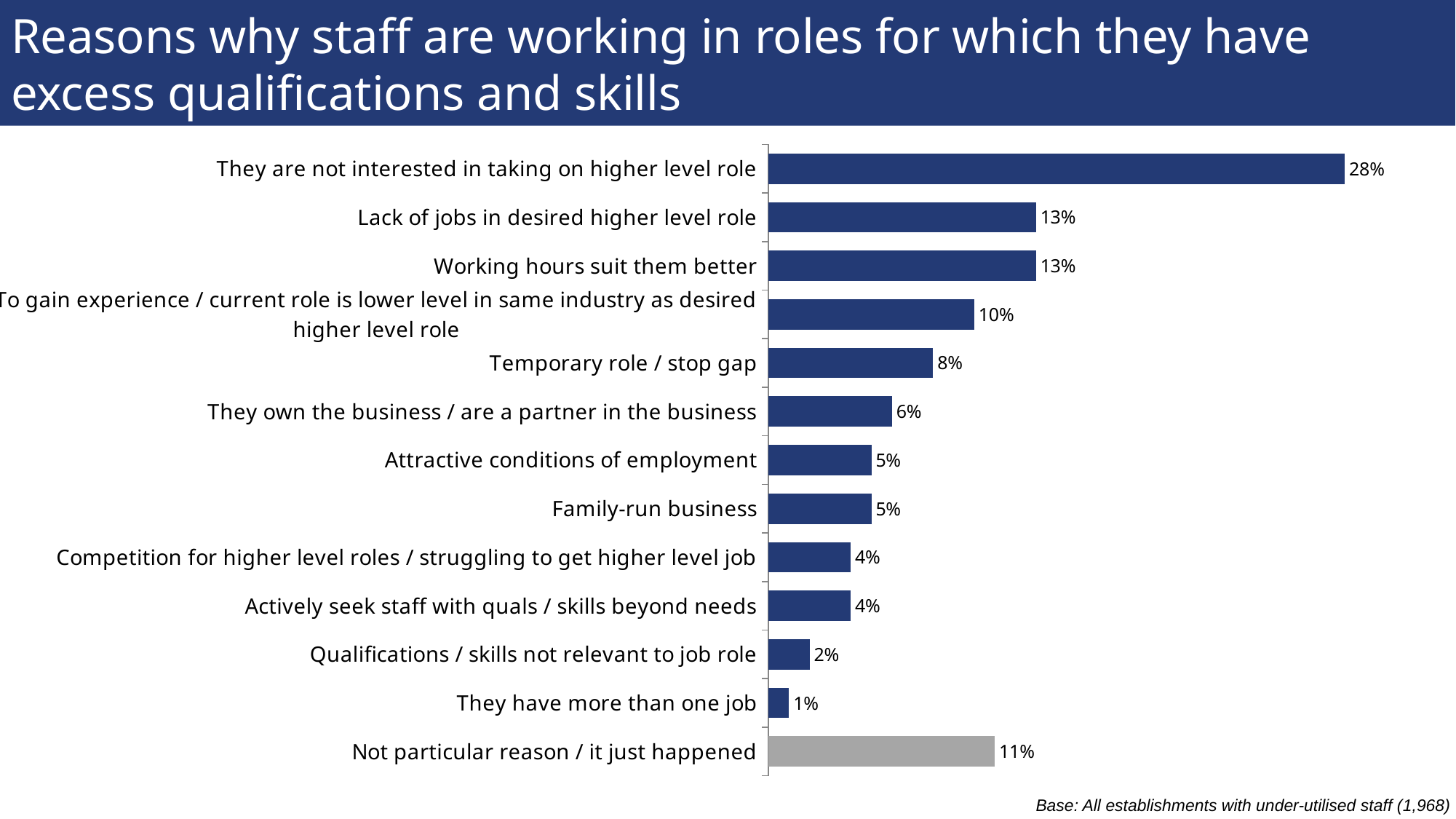
What is the value for 'Temporary role / stop gap'? 8% What percentage is shown for 'They are not interested in taking on higher level role'? 28% Which bar is coloured grey rather than dark blue? Not particular reason / it just happened What is the base stated at the bottom of the slide? All establishments with under-utilised staff (1,968) Which is larger: 'Not particular reason / it just happened' or 'To gain experience / current role is lower level in same industry as desired higher level role'? Not particular reason / it just happened What percentage is shown for 'Not particular reason / it just happened'? 11% How many reasons (bars) are shown in the chart? 13 Which reason has the highest percentage? They are not interested in taking on higher level role What type of chart is shown on the slide? Bar chart What is the difference between 'They are not interested in taking on higher level role' and 'Lack of jobs in desired higher level role'? 15% What is the difference between 'Temporary role / stop gap' and 'They own the business / are a partner in the business'? 2% Which reason has the lowest percentage? They have more than one job